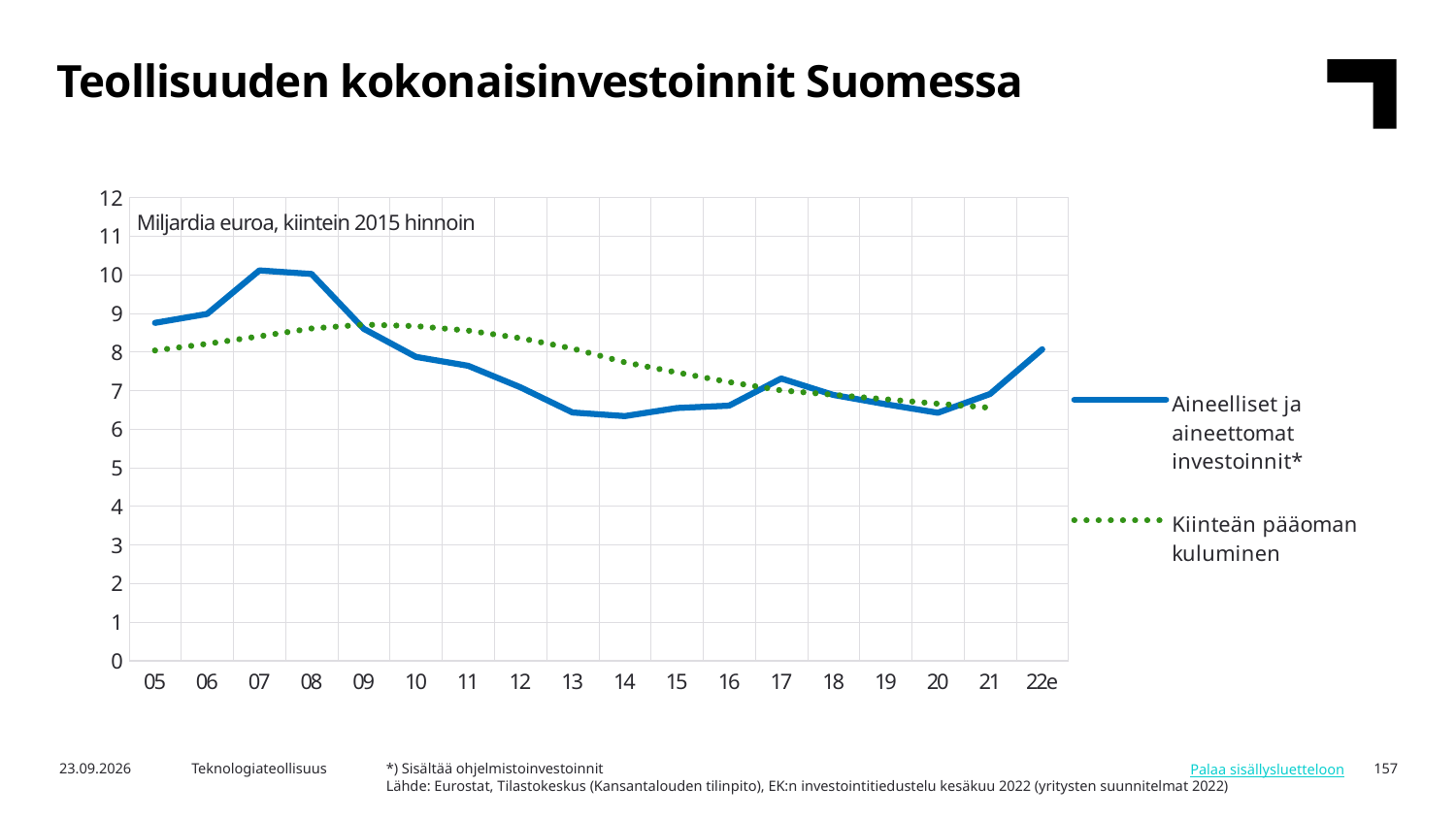
Is the value for 'Kiinteän pääoman kuluminen' in 05 greater or less than 7? greater How many series does the legend list? 2 Does the 'Kiinteän pääoman kuluminen' line rise or fall from 10 to 21? Fall Is the value for 'Aineelliset ja aineettomat investoinnit*' in 14 greater or less than 7? less What unit is stated inside the chart area? Miljardia euroa, kiintein 2015 hinnoin What kind of chart is shown on the slide? Line chart How many years (points) are shown on the x axis? 18 Is the value for 'Aineelliset ja aineettomat investoinnit*' in 07 greater or less than 9? greater In which year does the 'Kiinteän pääoman kuluminen' line reach its lowest value? 21 Which series has the larger value in 13: 'Aineelliset ja aineettomat investoinnit*' or 'Kiinteän pääoman kuluminen'? Kiinteän pääoman kuluminen In which year does the 'Aineelliset ja aineettomat investoinnit*' line reach its highest value? 07 Which series has the larger value in 07: 'Aineelliset ja aineettomat investoinnit*' or 'Kiinteän pääoman kuluminen'? Aineelliset ja aineettomat investoinnit*